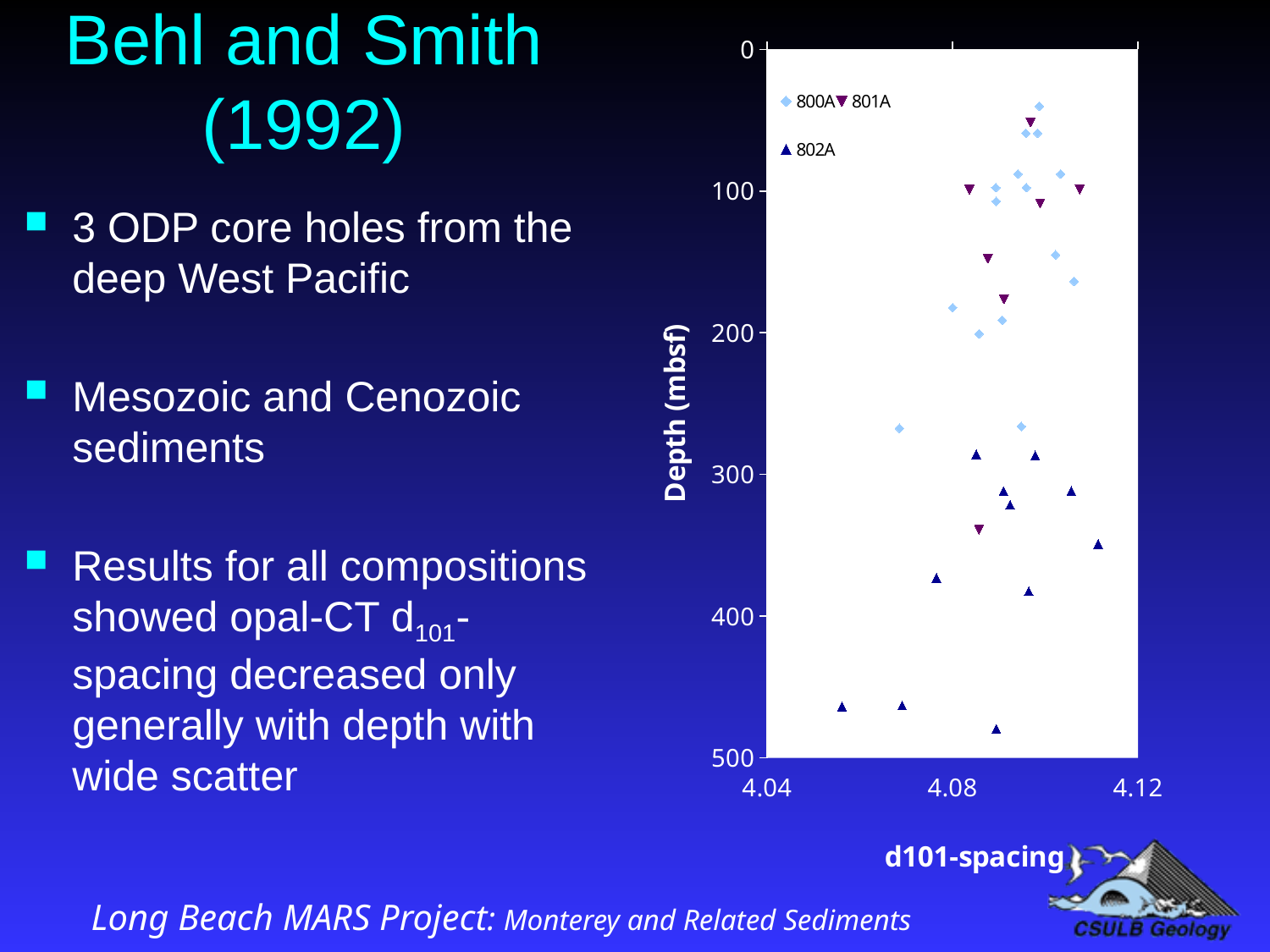
What are the three series named in the chart legend? 800A, 801A, 802A Which series contains the point with the smallest d101-spacing value? 802A Which series reaches the greatest depth on the chart? 802A How many series does the chart legend list? 3 As depth increases on the chart, does the d101-spacing generally increase or decrease? decrease Which series has points plotted at greater depths, 800A or 802A? 802A Are the deepest 802A points plotted at depths greater or less than 400 mbsf? greater What kind of chart is shown on the slide? scatter chart Are the 802A points plotted at depths greater or less than 100 mbsf? greater Are the 802A points plotted at depths greater or less than 200 mbsf? greater What is the title of the vertical axis of the chart? Depth (mbsf)